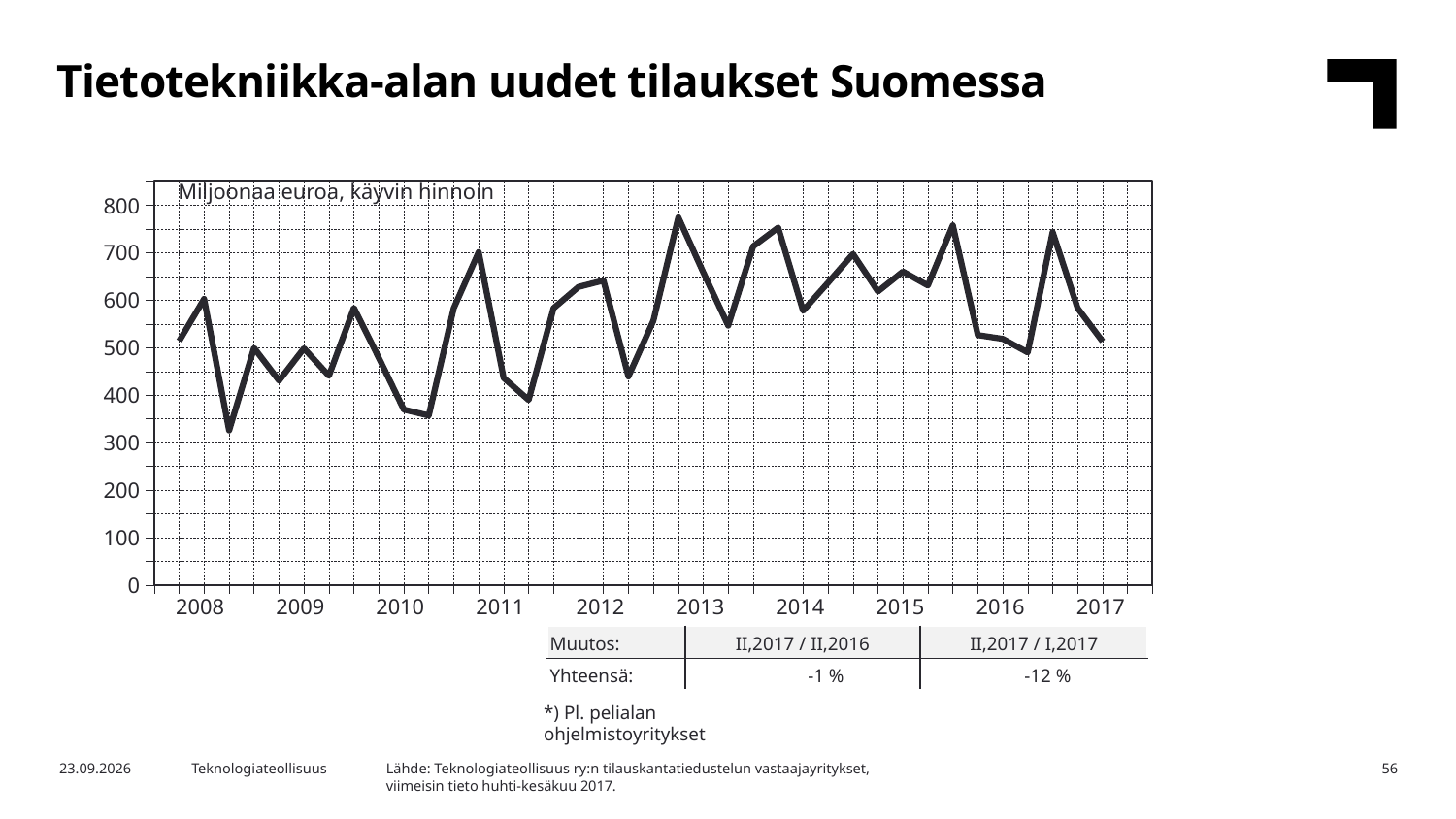
Is the highest point of the line in 2012 greater or less than 700? less According to the table below the chart, what is the change (Muutos) for Yhteensä from II,2017 / I,2017? -12 % What unit is stated in the label inside the chart area? Miljoonaa euroa, käyvin hinnoin What kind of chart is shown on the slide? line chart Is the lowest point of the line in 2008 greater or less than 400? less Does the line rise or fall from its 2016 peak to the last point in 2017? fall Is the highest point of the line in 2016 greater or less than 700? greater How many years are labelled on the x axis of the chart? 10 What is the title of the chart on the slide? Tietotekniikka-alan uudet tilaukset Suomessa How many lines are plotted in the chart? 1